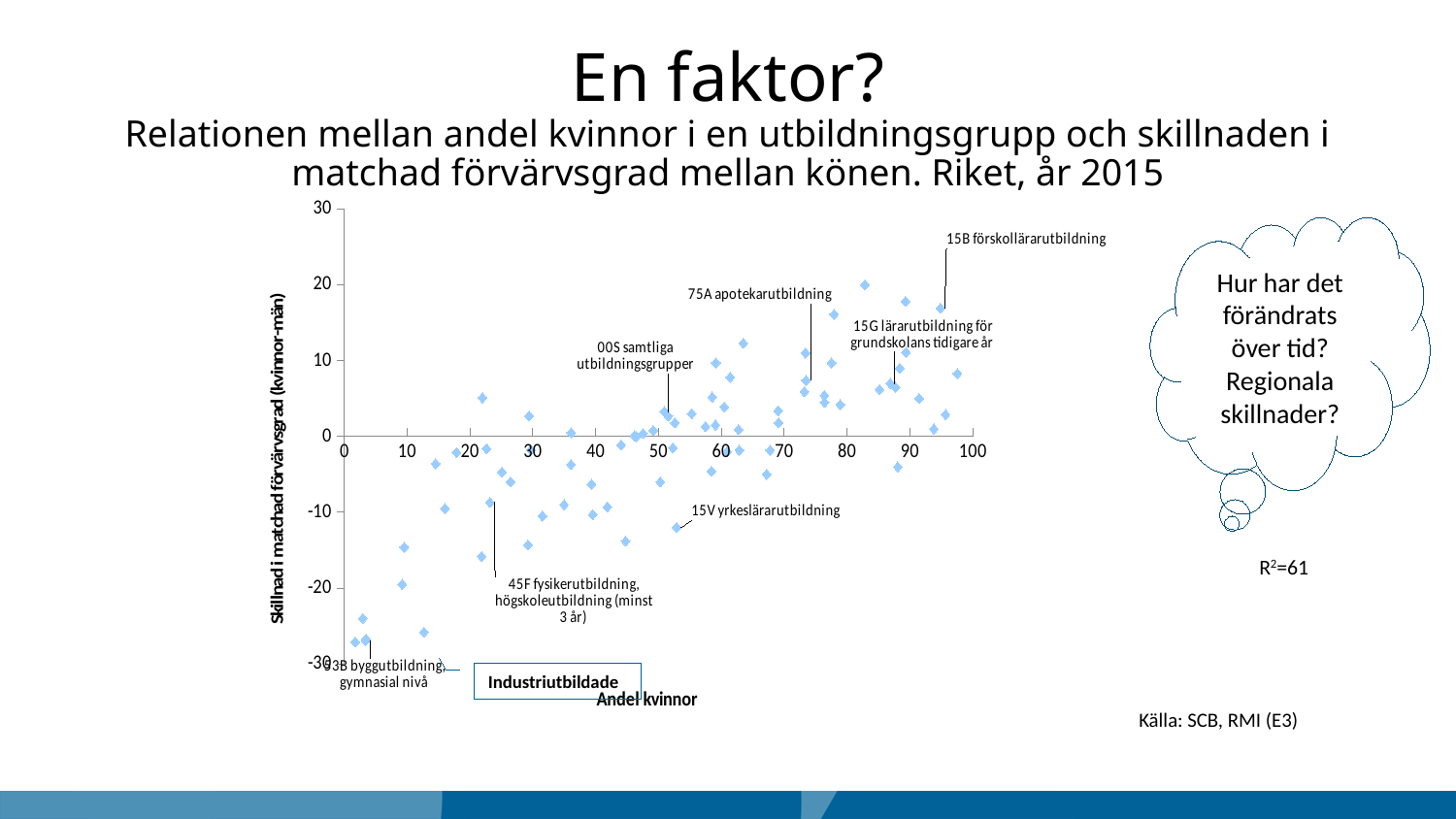
Do the plotted values generally rise or fall as the share of women (Andel kvinnor) increases along the x axis? Rise Which has the higher value: 75A apotekarutbildning or 15V yrkeslärarutbildning? 75A apotekarutbildning Is the value for 45F fysikerutbildning, högskoleutbildning (minst 3 år) greater or less than 0? less What R² value is stated next to the chart? R²=61 Is the value for 15B förskollärarutbildning greater or less than 10? greater Is the value for 15V yrkeslärarutbildning greater or less than 0? less What kind of chart is shown on the slide? Scatter plot Which has the higher value: 15B förskollärarutbildning or 03B byggutbildning, gymnasial nivå? 15B förskollärarutbildning What is the title of the x axis of the chart? Andel kvinnor Which has the higher value: 00S samtliga utbildningsgrupper or 45F fysikerutbildning, högskoleutbildning (minst 3 år)? 00S samtliga utbildningsgrupper